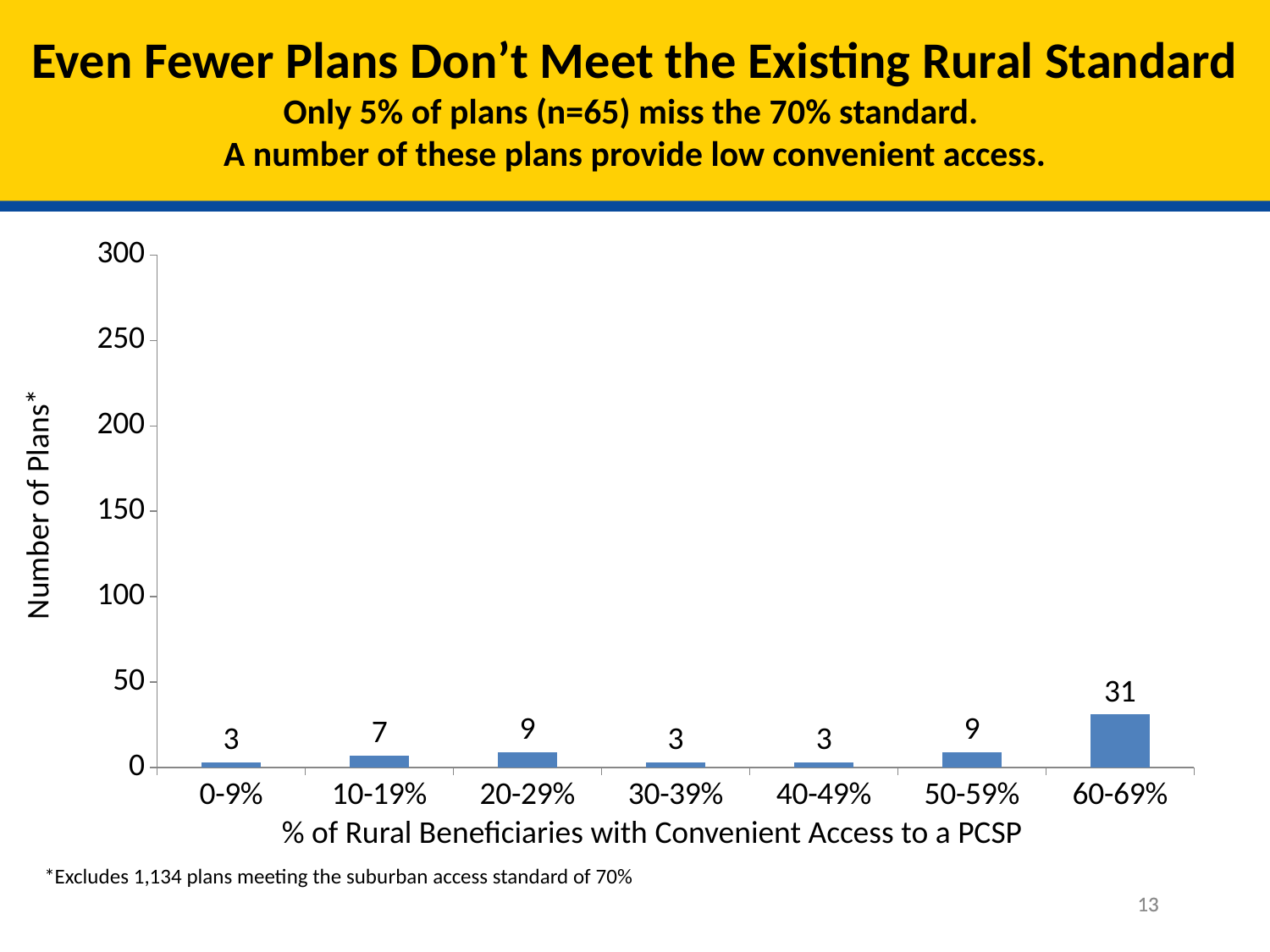
Is the value for the 60-69% category greater or less than 50? less What is the number of plans in the 10-19% category? 7 What is the label of the x axis? % of Rural Beneficiaries with Convenient Access to a PCSP What is the label of the y axis? Number of Plans* How many plans fall in the 60-69% category? 31 Which has more plans, the 10-19% category or the 30-39% category? 10-19% How many plans are in the 20-29% category? 9 How many categories are shown on the x axis? 7 What is the difference in number of plans between the 60-69% and 50-59% categories? 22 What is the total number of plans across all categories shown in the chart? 65 What kind of chart is shown on the slide? bar chart Which category has the highest number of plans? 60-69%